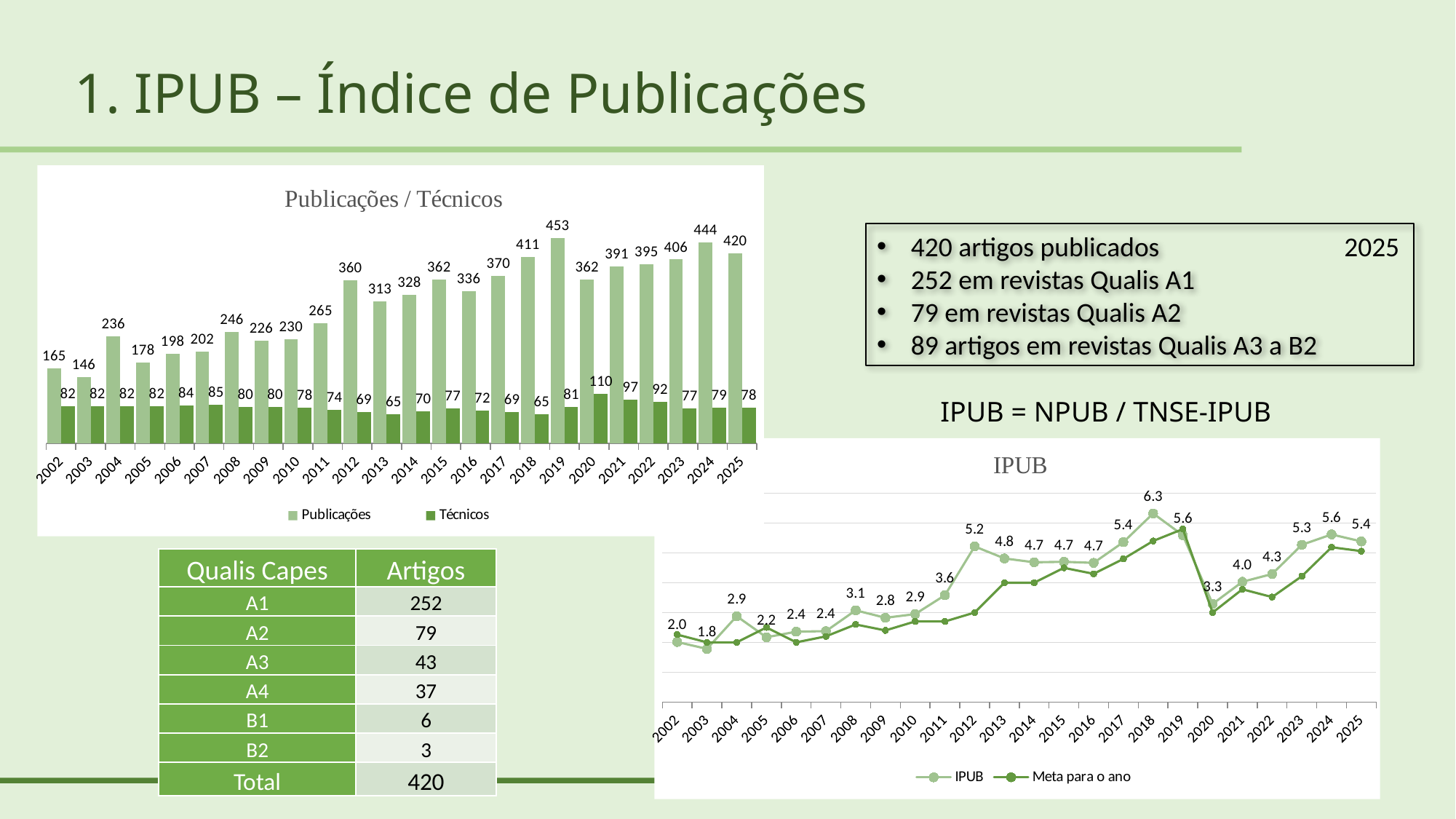
In the 'Publicações / Técnicos' chart, how many series does the legend list? 2 In the 'IPUB' chart, how many years are shown on the x axis? 24 In the 'IPUB' chart, is the IPUB value for 2012 larger or smaller than the value for 2020? Larger In the 'Publicações / Técnicos' chart, which year has the highest Técnicos value? 2020 In the 'Publicações / Técnicos' chart, what is the difference between the Publicações values for 2024 and 2025? 24 What kind of chart is the 'Publicações / Técnicos' chart? Bar chart In the 'IPUB' chart, what is the IPUB value for 2018? 6.3 In the 'Publicações / Técnicos' chart, which year has the highest Publicações value? 2019 In the 'Publicações / Técnicos' chart, which year has the lowest Publicações value? 2003 In the 'IPUB' chart, which year has the lowest IPUB value? 2003 In the 'Publicações / Técnicos' chart, what is the Publicações value for 2025? 420 In the 'Publicações / Técnicos' chart, what is the Publicações value for 2019? 453